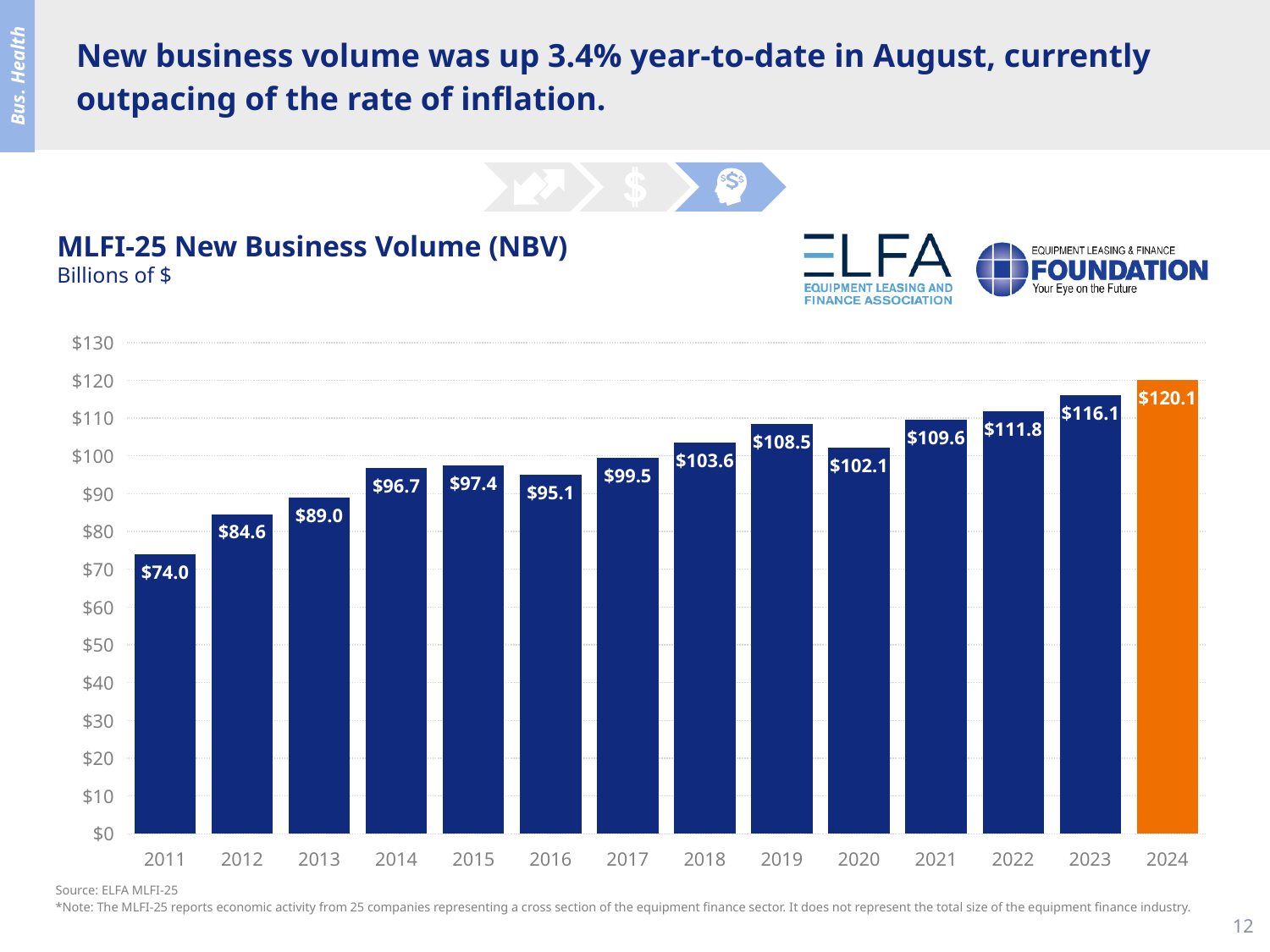
Is the value for 2013 greater or less than $90? less What is the difference between the new business volume in 2024 and in 2023? $4.0 Which bar is shown in a different colour (orange) from the others? 2024 What is the difference between the new business volume in 2019 and in 2020? $6.4 What is the MLFI-25 new business volume for 2020? $102.1 How many years are shown on the chart? 14 What is the MLFI-25 new business volume for 2011? $74.0 What is the MLFI-25 new business volume for 2024? $120.1 Which year has the lowest new business volume? 2011 What kind of chart is used to show MLFI-25 New Business Volume? Bar chart Which year has the highest new business volume? 2024 Which year has a larger new business volume, 2015 or 2016? 2015